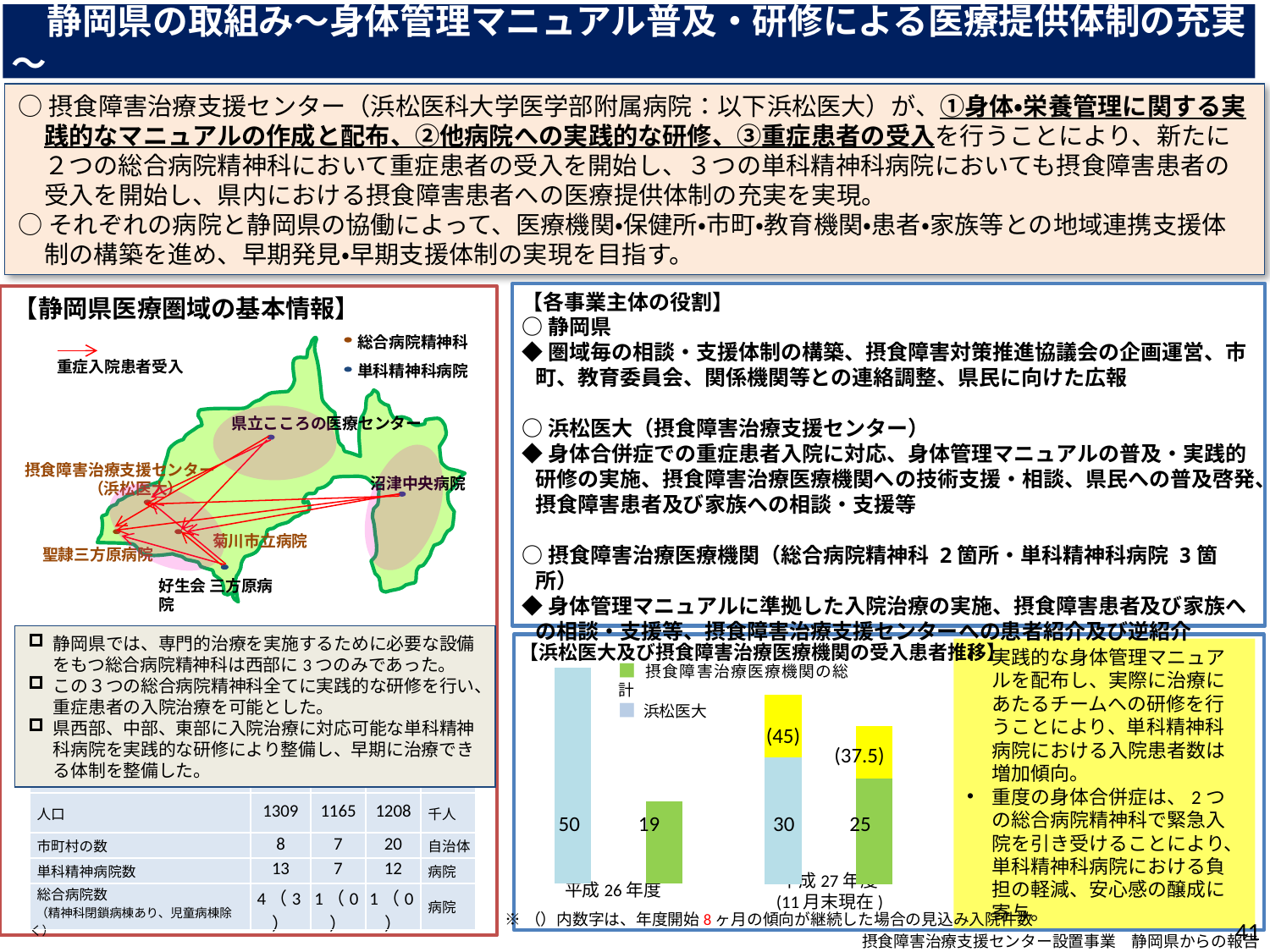
In the chart titled 【浜松医大及び摂食障害治療医療機関の受入患者推移】, what is the value for 摂食障害治療医療機関の総計 in 平成26年度? 19 In the chart titled 【浜松医大及び摂食障害治療医療機関の受入患者推移】, does the 浜松医大 value rise or fall from 平成26年度 to 平成27年度? fall In the chart titled 【浜松医大及び摂食障害治療医療機関の受入患者推移】, what is the value for 摂食障害治療医療機関の総計 in 平成27年度 (11月末現在)? 25 In the chart titled 【浜松医大及び摂食障害治療医療機関の受入患者推移】, what projected value is shown in parentheses above the 摂食障害治療医療機関の総計 bar for 平成27年度? (37.5) How many series does the legend of the chart titled 【浜松医大及び摂食障害治療医療機関の受入患者推移】 list? 2 In the chart titled 【浜松医大及び摂食障害治療医療機関の受入患者推移】, does the 摂食障害治療医療機関の総計 value rise or fall from 平成26年度 to 平成27年度? rise What kind of chart is the one titled 【浜松医大及び摂食障害治療医療機関の受入患者推移】? bar chart In the chart titled 【浜松医大及び摂食障害治療医療機関の受入患者推移】, what is the difference between the 浜松医大 value and the 摂食障害治療医療機関の総計 value in 平成26年度? 31 In the chart titled 【浜松医大及び摂食障害治療医療機関の受入患者推移】, what is the value for 浜松医大 in 平成27年度 (11月末現在)? 30 In the chart titled 【浜松医大及び摂食障害治療医療機関の受入患者推移】, what is the value for 浜松医大 in 平成26年度? 50 In the chart titled 【浜松医大及び摂食障害治療医療機関の受入患者推移】, what projected value is shown in parentheses above the 浜松医大 bar for 平成27年度? (45) In the chart titled 【浜松医大及び摂食障害治療医療機関の受入患者推移】, which is larger in 平成27年度: 浜松医大 or 摂食障害治療医療機関の総計? 浜松医大